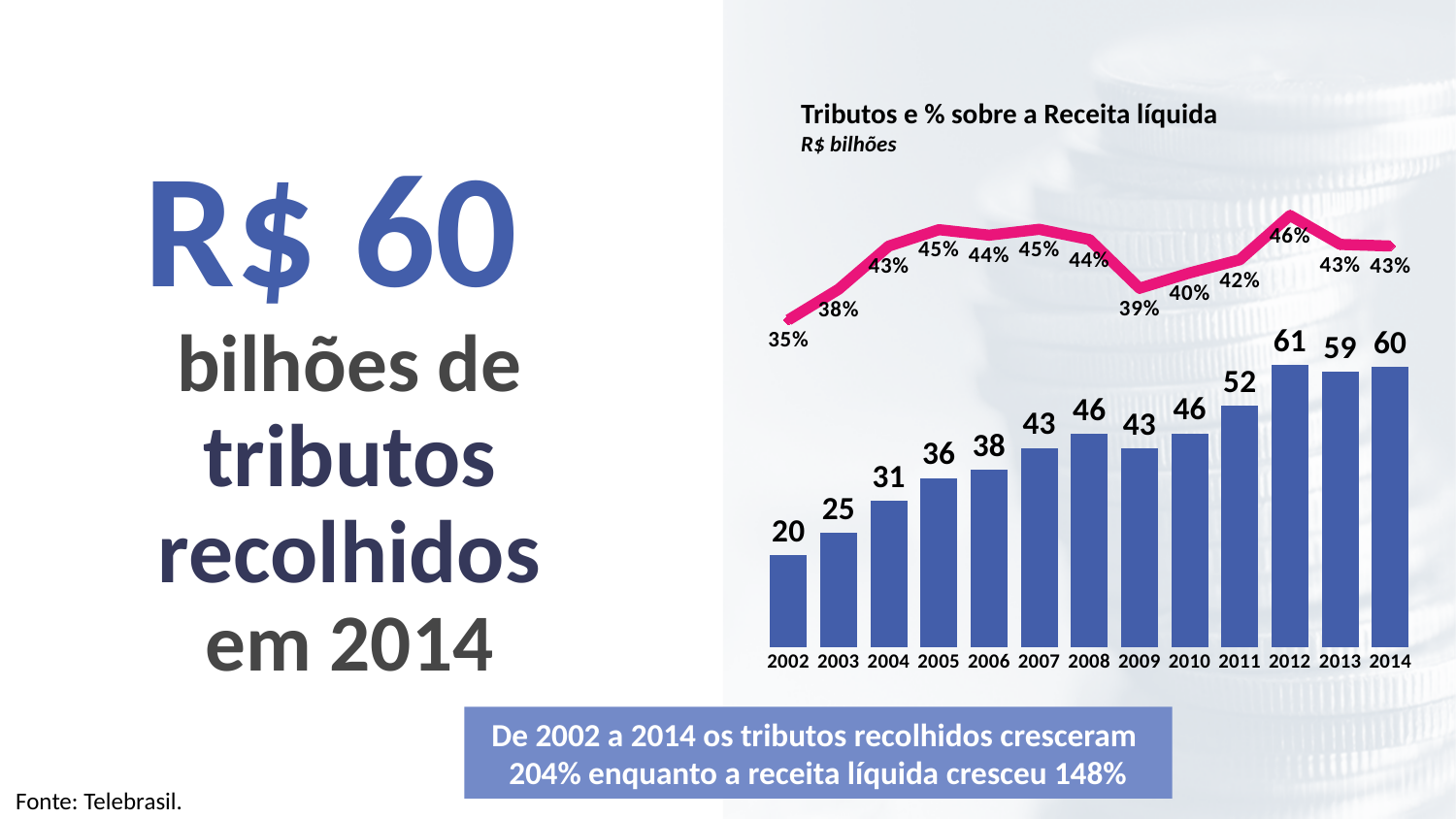
Which year has the lowest bar value? 2002 Which year has a larger bar value, 2011 or 2013? 2013 What percentage does the line show for 2009? 39% What percentage does the line show for 2012? 46% What is the difference between the bar values for 2014 and 2002? 40 What is the value of the bar for 2002? 20 What kind of chart is shown on the slide? Combined bar and line chart What is the value of the bar for 2014? 60 What is the title of the chart? Tributos e % sobre a Receita líquida How many years are shown on the x axis? 13 Which year has the highest bar value? 2012 Do the bar values generally rise or fall from 2002 to 2012? Rise